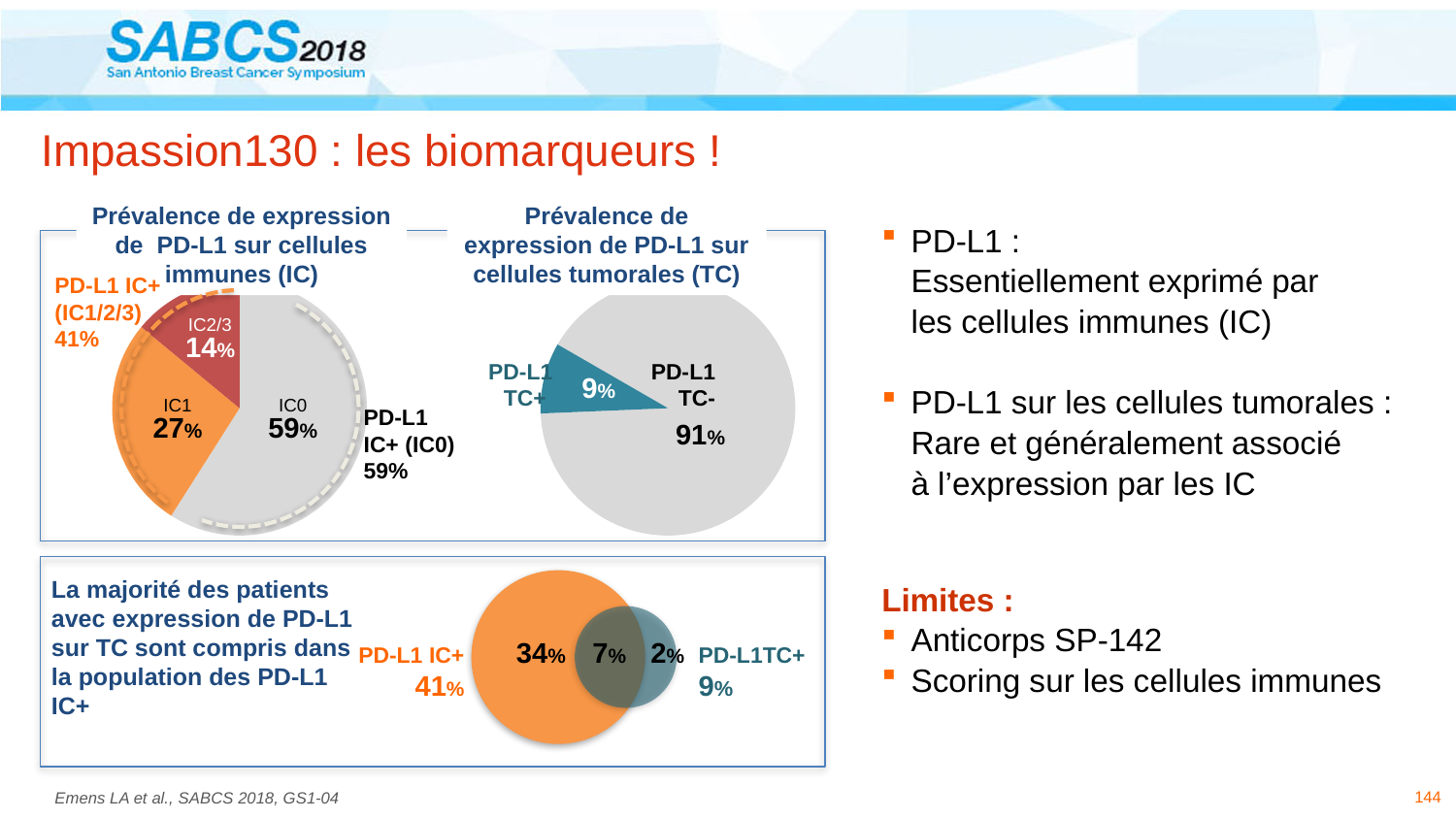
In the pie chart 'Prévalence de expression de PD-L1 sur cellules tumorales (TC)', what is the value for PD-L1 TC-? 91% In the pie chart 'Prévalence de expression de PD-L1 sur cellules immunes (IC)', what is the value for IC0? 59% In the pie chart 'Prévalence de expression de PD-L1 sur cellules immunes (IC)', how many slices are there? 3 In the pie chart 'Prévalence de expression de PD-L1 sur cellules immunes (IC)', which slice is the smallest? IC2/3 In the pie chart 'Prévalence de expression de PD-L1 sur cellules immunes (IC)', what is the difference between IC1 and IC2/3? 13% In the pie chart 'Prévalence de expression de PD-L1 sur cellules immunes (IC)', what is the value for IC2/3? 14% In the pie chart 'Prévalence de expression de PD-L1 sur cellules immunes (IC)', what is the value for IC1? 27% In the Venn diagram at the bottom of the slide, what is the value of the overlap between PD-L1 IC+ and PD-L1 TC+? 7% In the pie chart 'Prévalence de expression de PD-L1 sur cellules immunes (IC)', which slice is the largest? IC0 What type of chart is used for 'Prévalence de expression de PD-L1 sur cellules tumorales (TC)'? Pie chart In the pie chart 'Prévalence de expression de PD-L1 sur cellules tumorales (TC)', which is larger, PD-L1 TC+ or PD-L1 TC-? PD-L1 TC- In the pie chart 'Prévalence de expression de PD-L1 sur cellules tumorales (TC)', what is the value for PD-L1 TC+? 9%